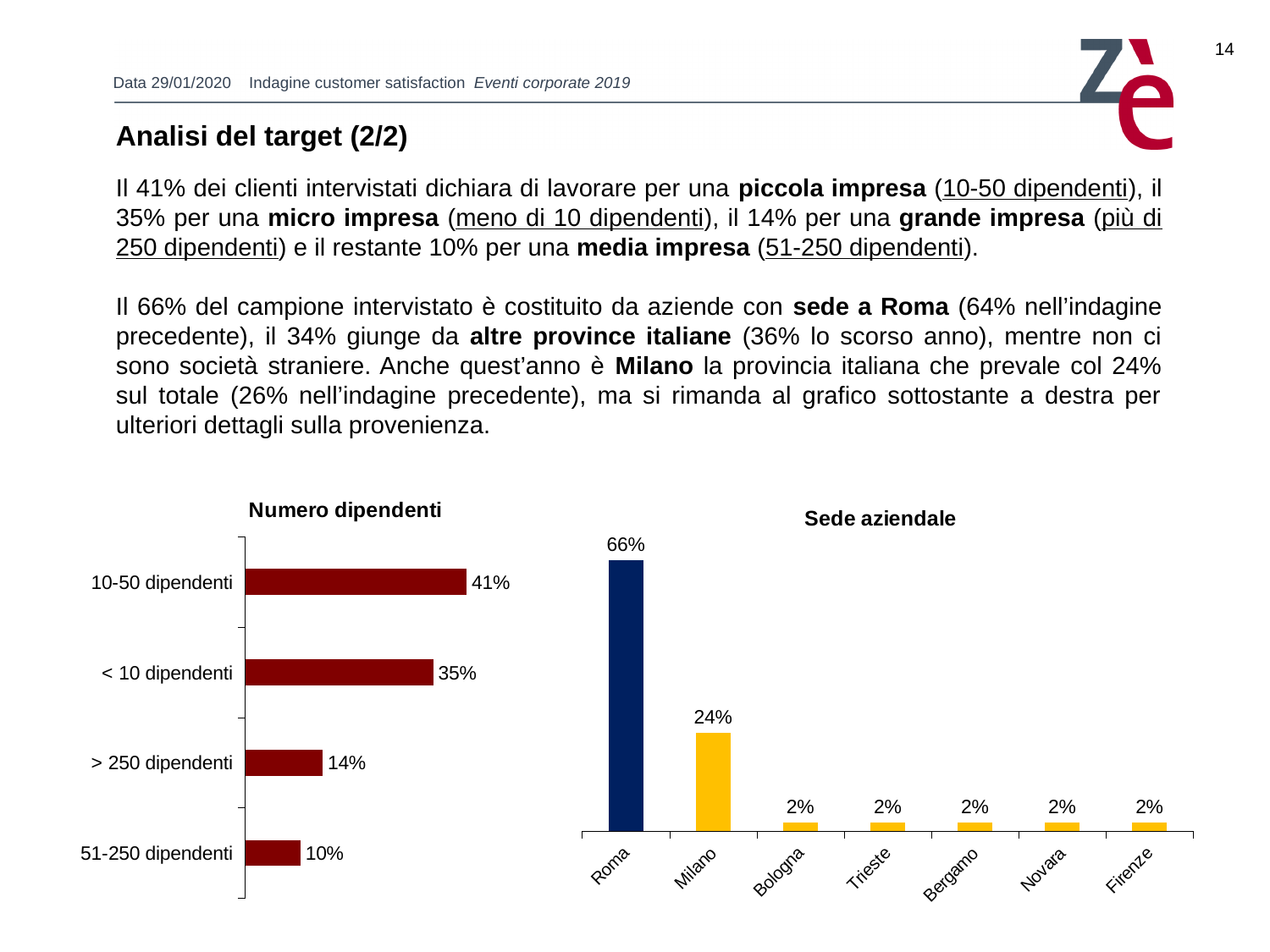
In the 'Sede aziendale' chart, what is the value for Bergamo? 2% In the 'Sede aziendale' chart, which bar is coloured dark blue rather than yellow? Roma In the 'Numero dipendenti' chart, what is the difference between '< 10 dipendenti' and '> 250 dipendenti'? 21% In the 'Sede aziendale' chart, what is the difference between Roma and Milano? 42% In the 'Sede aziendale' chart, what is the value for Milano? 24% In the 'Numero dipendenti' chart, how many categories are shown? 4 What kind of chart is the 'Numero dipendenti' chart? Bar chart In the 'Numero dipendenti' chart, what is the value for '10-50 dipendenti'? 41% In the 'Numero dipendenti' chart, what is the value for '51-250 dipendenti'? 10% In the 'Sede aziendale' chart, how many cities are shown on the x axis? 7 In the 'Sede aziendale' chart, which city has the highest value? Roma In the 'Numero dipendenti' chart, which category has the lowest value? 51-250 dipendenti